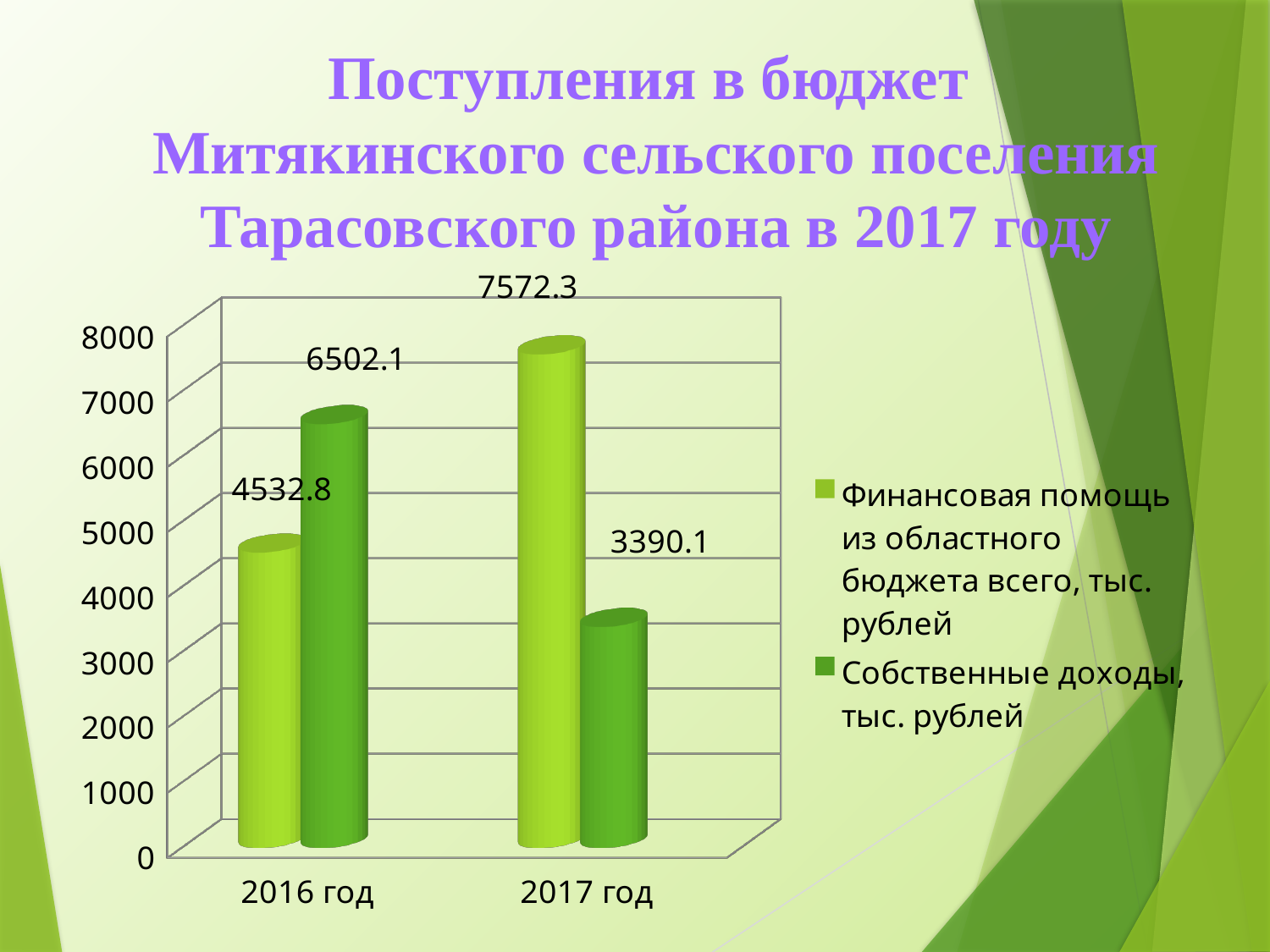
Which bar has the lowest value on the chart? Собственные доходы, 2017 год What is the difference between Финансовая помощь из областного бюджета in 2017 год and in 2016 год? 3039.5 What is the value of Финансовая помощь из областного бюджета for 2017 год? 7572.3 What kind of chart is shown on the slide? Bar chart What is the value of Собственные доходы for 2016 год? 6502.1 Which bar has the highest value on the chart? Финансовая помощь из областного бюджета, 2017 год How many categories are shown on the x axis? 2 Which is larger in 2016 год: Финансовая помощь из областного бюджета or Собственные доходы? Собственные доходы What is the value of Финансовая помощь из областного бюджета for 2016 год? 4532.8 How many series does the legend list? 2 Do the values for Собственные доходы rise or fall from 2016 год to 2017 год? Fall What is the value of Собственные доходы for 2017 год? 3390.1